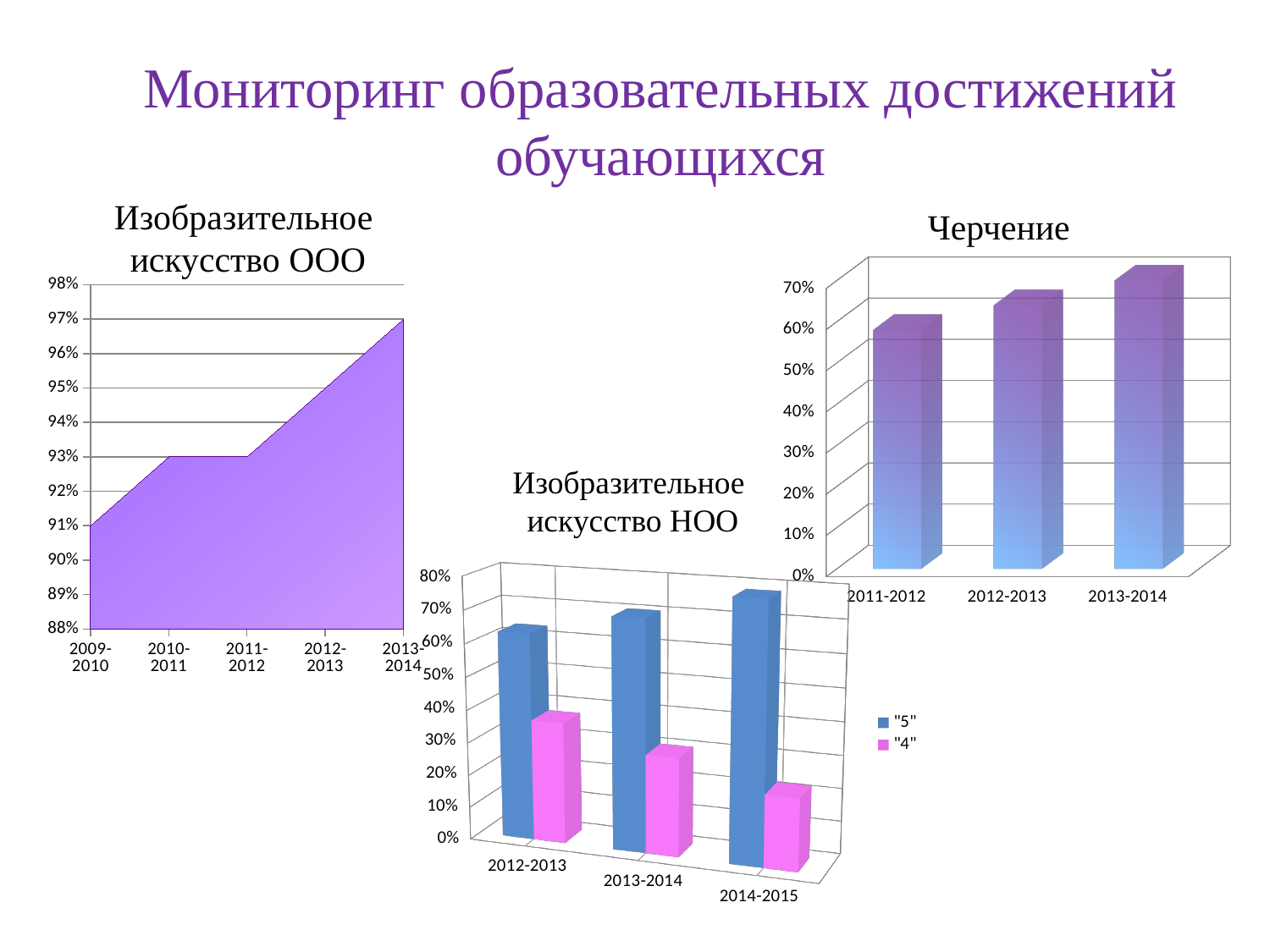
How many school years are shown on the x axis of the "Изобразительное искусство ООО" chart? 5 In the "Изобразительное искусство НОО" chart, do the values for the "4" series rise or fall from 2012-2013 to 2014-2015? fall In the "Черчение" chart, which school year has the highest value? 2013-2014 In the "Изобразительное искусство НОО" chart, which series has the larger value for 2014-2015, "5" or "4"? "5" In the "Изобразительное искусство ООО" chart, what is the value for 2009-2010? 91% How many series does the legend of the "Изобразительное искусство НОО" chart list? 2 In the "Черчение" chart, is the value for 2011-2012 greater or less than 50%? greater In the "Изобразительное искусство ООО" chart, do the values rise or fall from 2009-2010 to 2013-2014? rise In the "Черчение" chart, which school year has the lowest value? 2011-2012 What kind of chart is the "Изобразительное искусство ООО" chart? area chart In the "Изобразительное искусство ООО" chart, what is the value for 2013-2014? 97% What kind of chart is the "Черчение" chart? bar chart